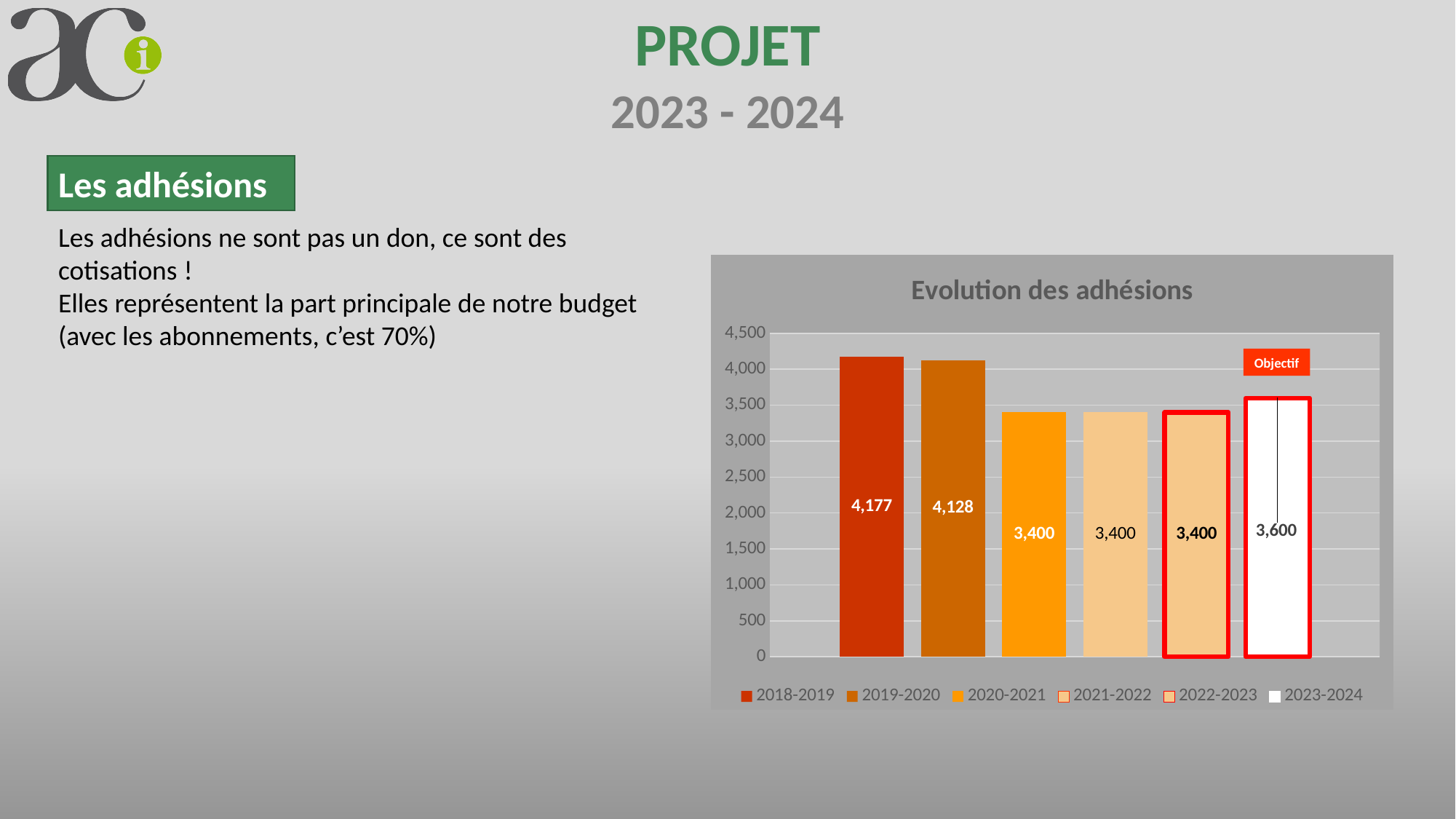
Which series has the highest value in the 'Evolution des adhésions' chart? 2018-2019 What kind of chart is 'Evolution des adhésions'? bar chart What is the difference between the 2023-2024 and 2022-2023 values in the 'Evolution des adhésions' chart? 200 What is the value for 2023-2024 in the 'Evolution des adhésions' chart? 3,600 What is the value for 2018-2019 in the 'Evolution des adhésions' chart? 4,177 What label is shown in the red box above the 2023-2024 bar in the 'Evolution des adhésions' chart? Objectif What is the value for 2019-2020 in the 'Evolution des adhésions' chart? 4,128 What is the value for 2021-2022 in the 'Evolution des adhésions' chart? 3,400 What is the difference between the 2018-2019 and 2019-2020 values in the 'Evolution des adhésions' chart? 49 Is the value for 2023-2024 in the 'Evolution des adhésions' chart greater or less than 4,000? less How many series does the legend of the 'Evolution des adhésions' chart list? 6 Which is larger in the 'Evolution des adhésions' chart, the value for 2019-2020 or the value for 2020-2021? 2019-2020